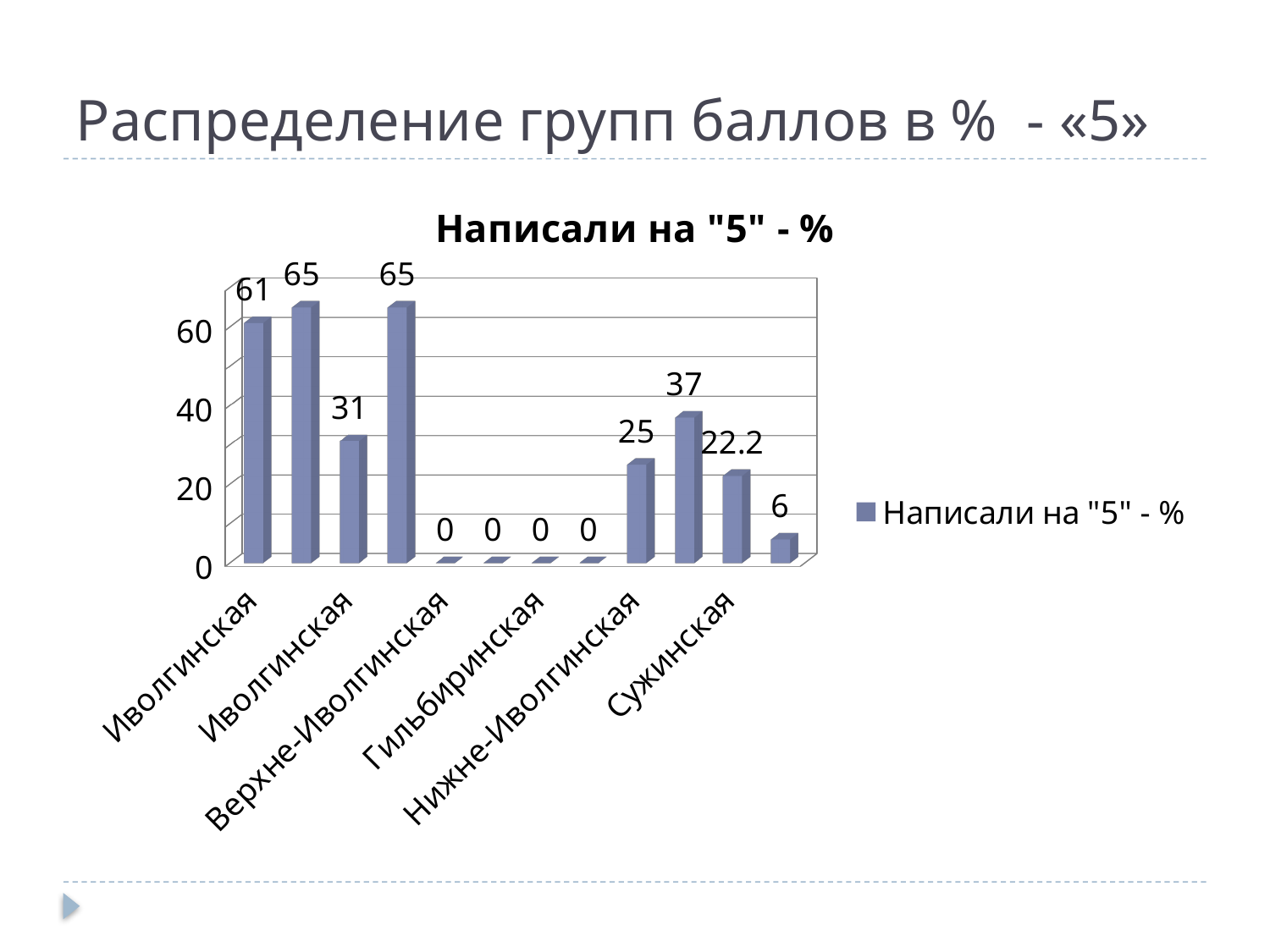
What is the title of the chart? Написали на "5" - % What type of chart is shown on the slide? bar chart What is the value of the last bar on the right of the chart? 6 How many bars in the chart have a value of 0? 4 How many bars are plotted in the chart? 12 What is the highest value shown in the chart? 65 What is the difference between the highest value (65) and the first bar's value (61)? 4 What is the value of the first bar on the left of the chart? 61 What is the lowest value shown in the chart? 0 Is the value of the bar labelled 37 greater or less than 40? less How many series does the legend list? 1 Which is larger: the bar labelled 37 or the bar labelled 22.2? 37